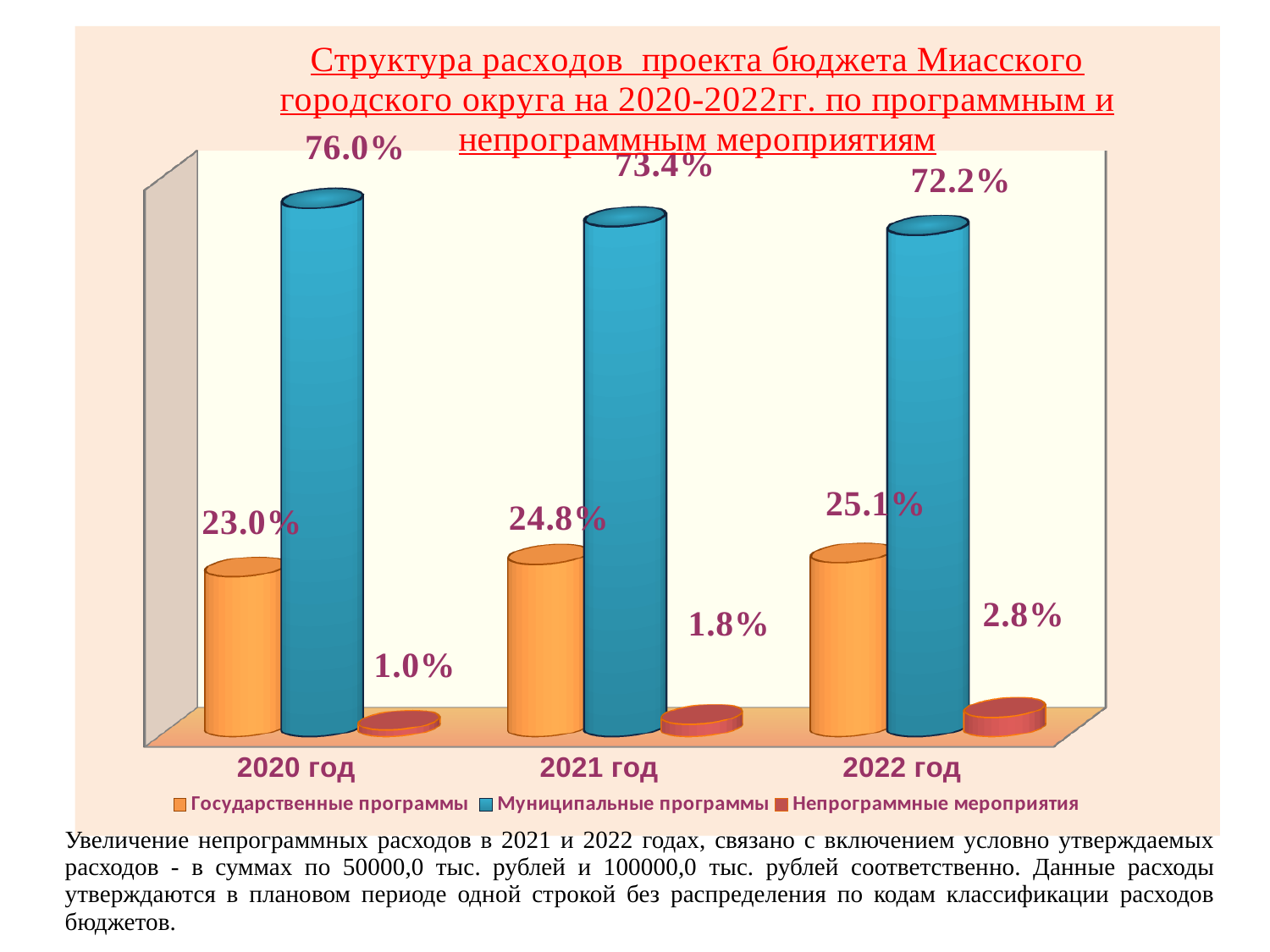
Which is larger: Государственные программы in 2021 год or in 2022 год? 2022 год Do the values for Муниципальные программы rise or fall from 2020 год to 2022 год? Fall What is the value for Муниципальные программы in 2020 год? 76.0% What is the difference between the Муниципальные программы values for 2020 год and 2022 год? 3.8% What kind of chart is shown on the slide? Bar chart In which year is the value for Муниципальные программы the highest? 2020 год What is the value for Непрограммные мероприятия in 2021 год? 1.8% How many year categories are shown on the x axis? 3 Which series is shown in blue in the legend? Муниципальные программы What is the value for Государственные программы in 2022 год? 25.1% How many series does the legend list? 3 In which year is the value for Непрограммные мероприятия the lowest? 2020 год